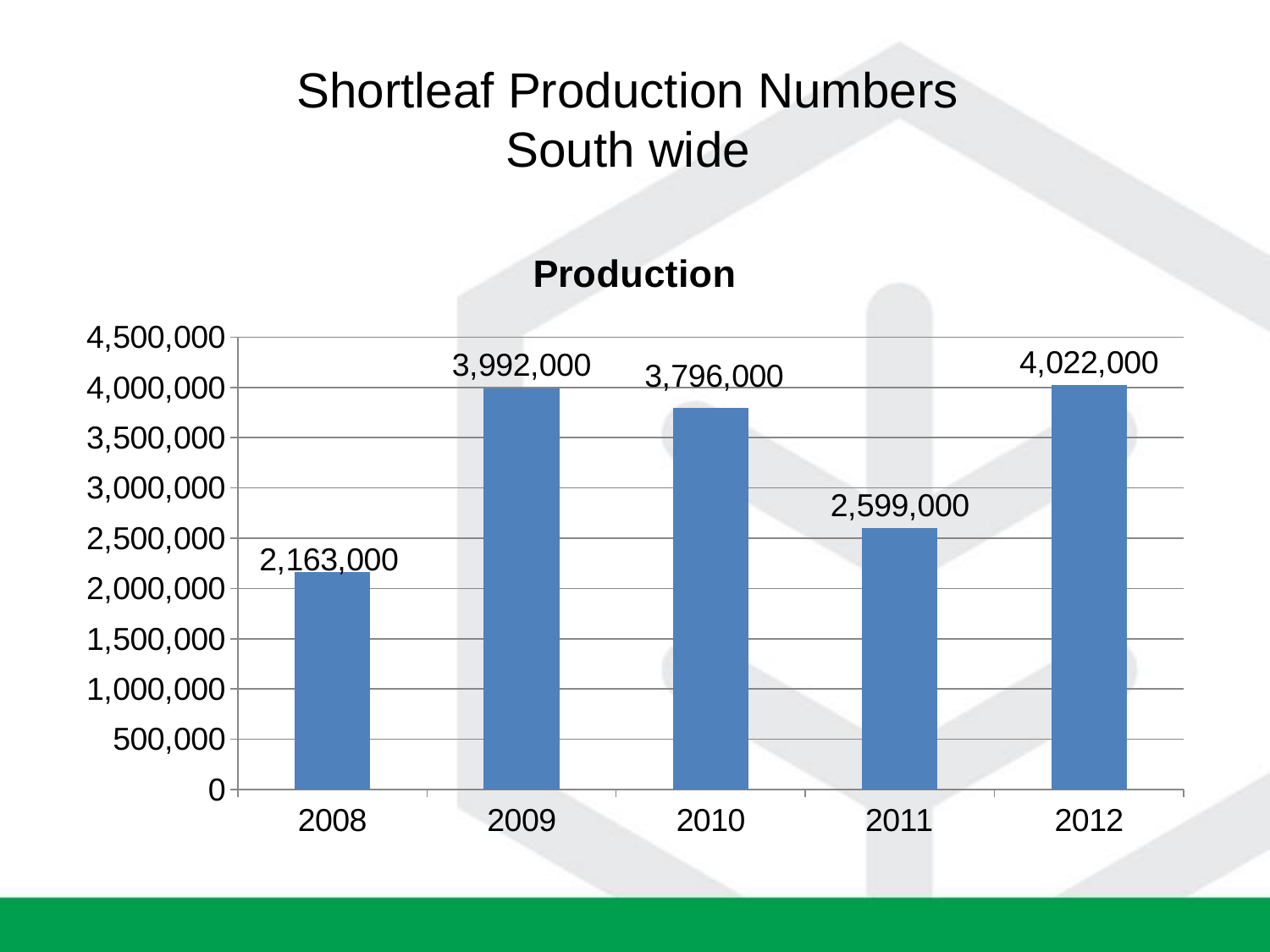
What is the title of the chart? Production What is the production value for 2009? 3,992,000 What is the difference in production between 2012 and 2011? 1,423,000 What is the production value for 2008? 2,163,000 Is the production value for 2010 greater or less than 3,500,000? greater Which year has the highest production? 2012 What is the production value for 2011? 2,599,000 What kind of chart is shown on the slide? bar chart Which year has higher production, 2010 or 2011? 2010 How many years are shown on the chart? 5 Which year has the lowest production? 2008 What is the difference in production between 2009 and 2010? 196,000